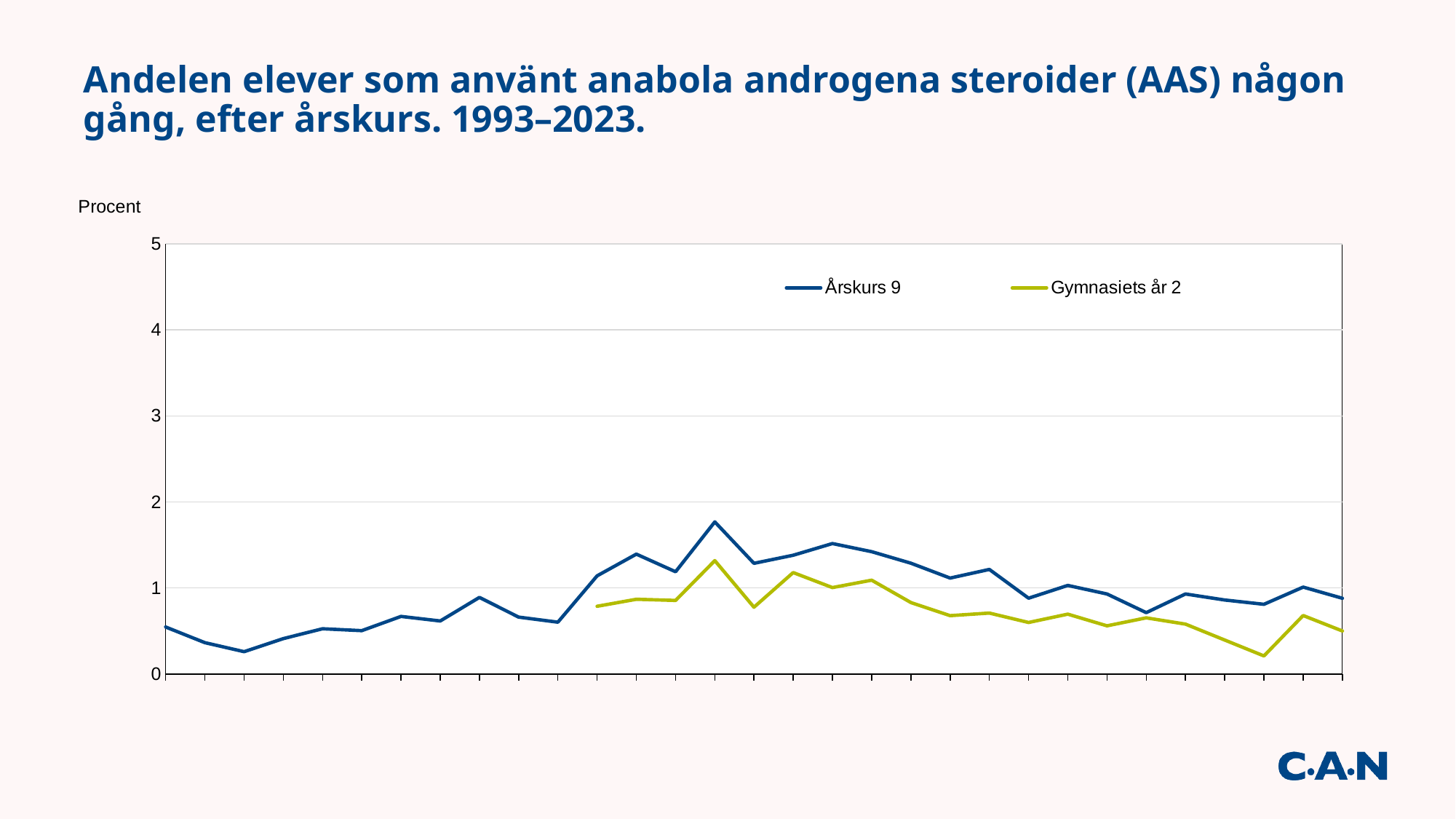
What kind of chart is shown on the slide? line chart What is the highest value shown on the y axis? 5 Is the highest value of the Årskurs 9 line greater or less than 1? greater Is the first plotted value of the Årskurs 9 line greater or less than 1? less Is the highest value of the Årskurs 9 line greater or less than 2? less What are the names of the two series in the legend? Årskurs 9 and Gymnasiets år 2 How many series does the legend list? 2 Which series lies above the other for the period where both are plotted? Årskurs 9 Which series reaches the higher peak, Årskurs 9 or Gymnasiets år 2? Årskurs 9 What unit is shown on the y axis label? Procent